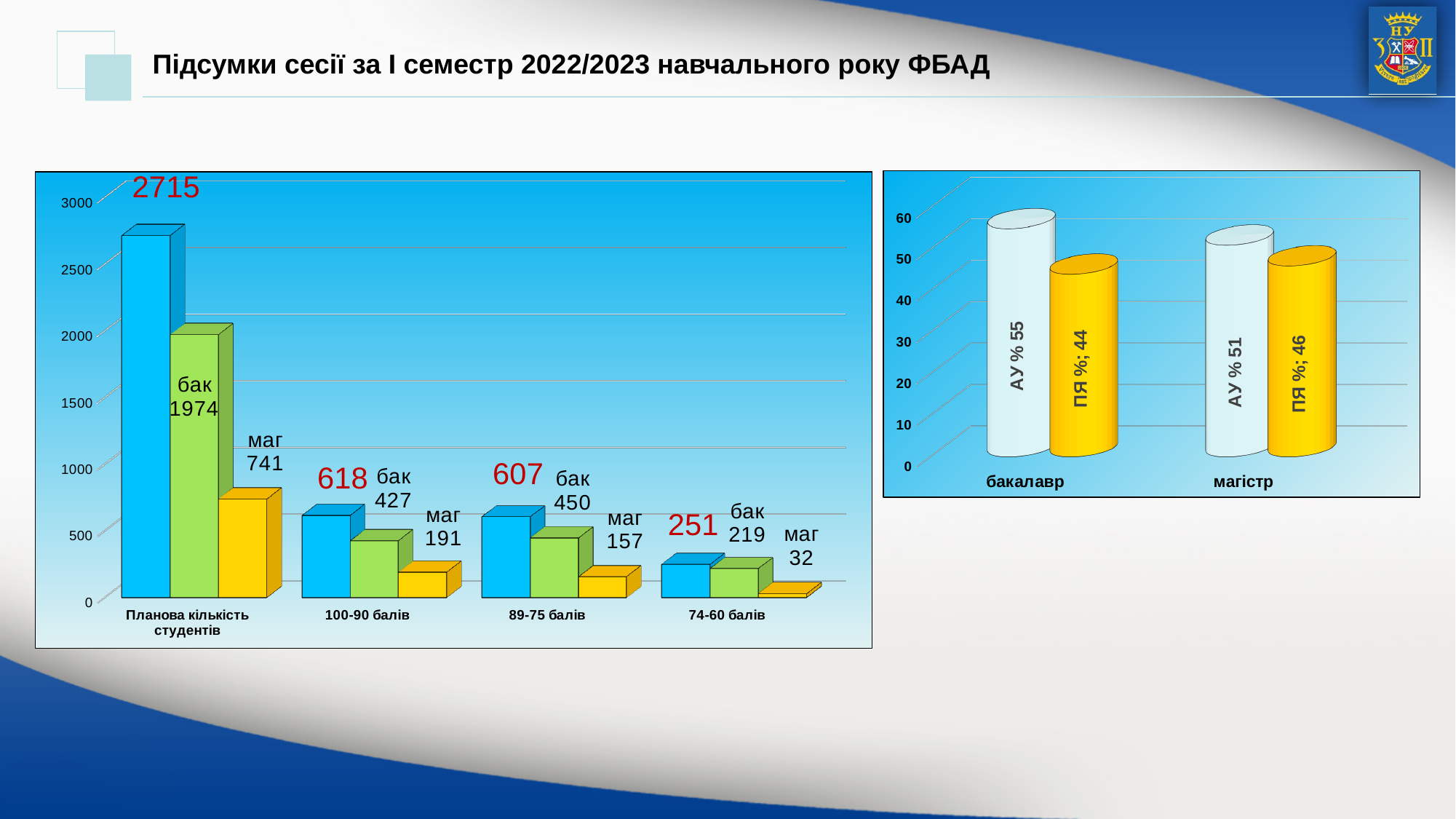
On the right chart, what is the difference between the 'АУ %' value and the 'ПЯ %' value for 'бакалавр'? 11 What kind of chart is the left chart? bar chart On the left chart, what is the 'маг' value for '74-60 балів'? 32 How many categories are shown on the x axis of the left chart? 4 On the left chart, what is the difference between the 'бак' value for '89-75 балів' and the 'бак' value for '100-90 балів'? 23 On the left chart, what is the total value shown in red for 'Планова кількість студентів'? 2715 On the right chart, what is the 'АУ %' value for 'бакалавр'? 55 On the left chart, which category has the lowest red total value? 74-60 балів On the left chart, what is the 'бак' value for '100-90 балів'? 427 On the left chart, which is larger: the red total for '100-90 балів' or the red total for '89-75 балів'? 100-90 балів On the left chart, what is the 'маг' value for '89-75 балів'? 157 On the right chart, what is the 'ПЯ %' value for 'магістр'? 46